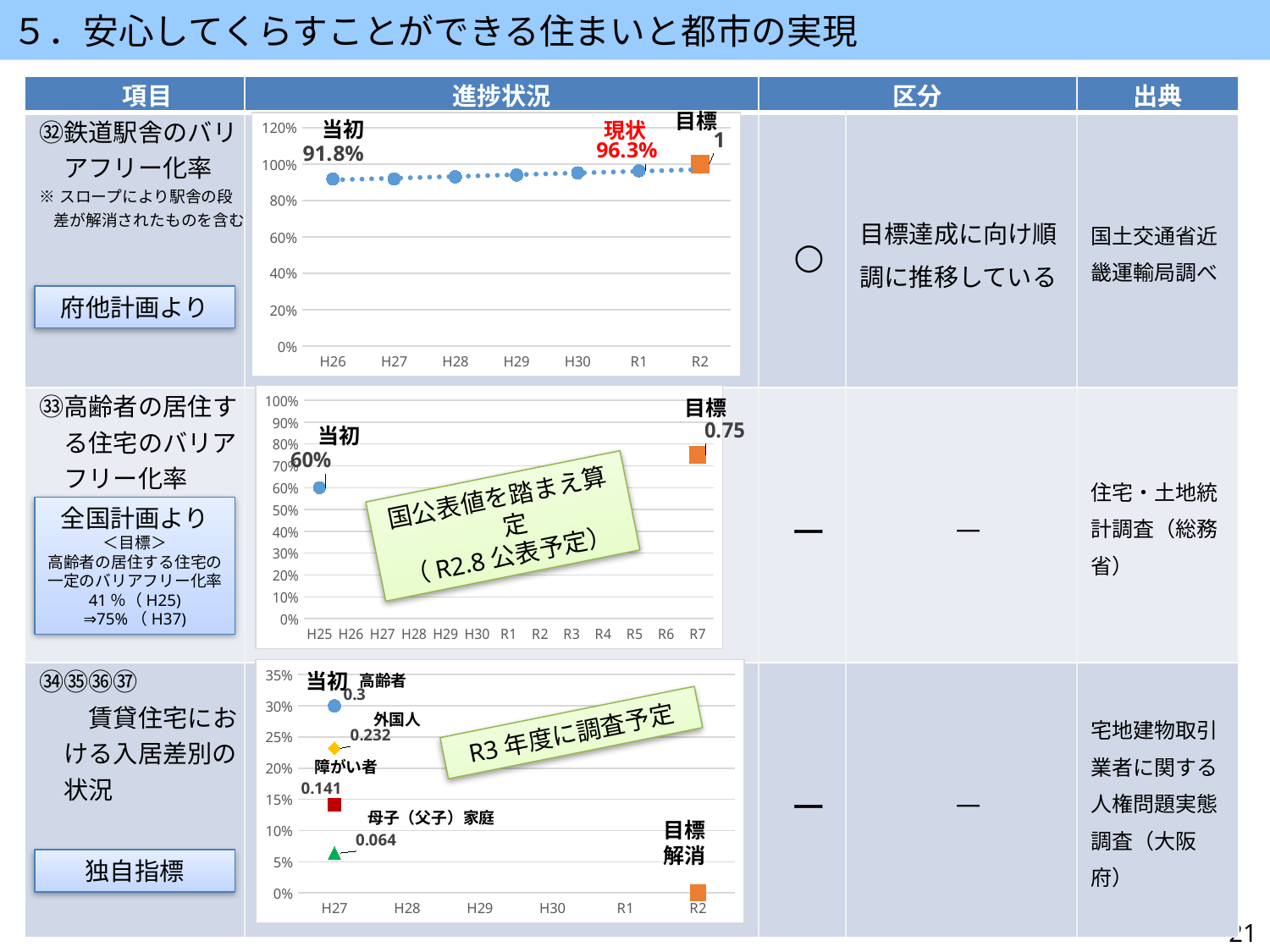
In the top chart (鉄道駅舎のバリアフリー化率), what is the 現状 value? 96.3% In the bottom chart (賃貸住宅における入居差別の状況), which is larger, the value for 外国人 or the value for 障がい者? 外国人 In the top chart (鉄道駅舎のバリアフリー化率), how many year categories are on the x axis? 7 In the top chart (鉄道駅舎のバリアフリー化率), what is the difference between the 現状 value and the 当初 value? 4.5% In the top chart (鉄道駅舎のバリアフリー化率), do the plotted values rise or fall from H26 to R1? rise In the bottom chart (賃貸住宅における入居差別の状況), which group has the lowest 当初 value? 母子（父子）家庭 In the middle chart (高齢者の居住する住宅のバリアフリー化率), how many year categories are on the x axis? 13 In the top chart (鉄道駅舎のバリアフリー化率), what is the 目標 value shown? 1 In the middle chart (高齢者の居住する住宅のバリアフリー化率), what is the 目標 value shown? 0.75 In the top chart (鉄道駅舎のバリアフリー化率), what is the 当初 value? 91.8% In the bottom chart (賃貸住宅における入居差別の状況), what is the 当初 value for 高齢者? 0.3 In the middle chart (高齢者の居住する住宅のバリアフリー化率), what is the 当初 value? 60%